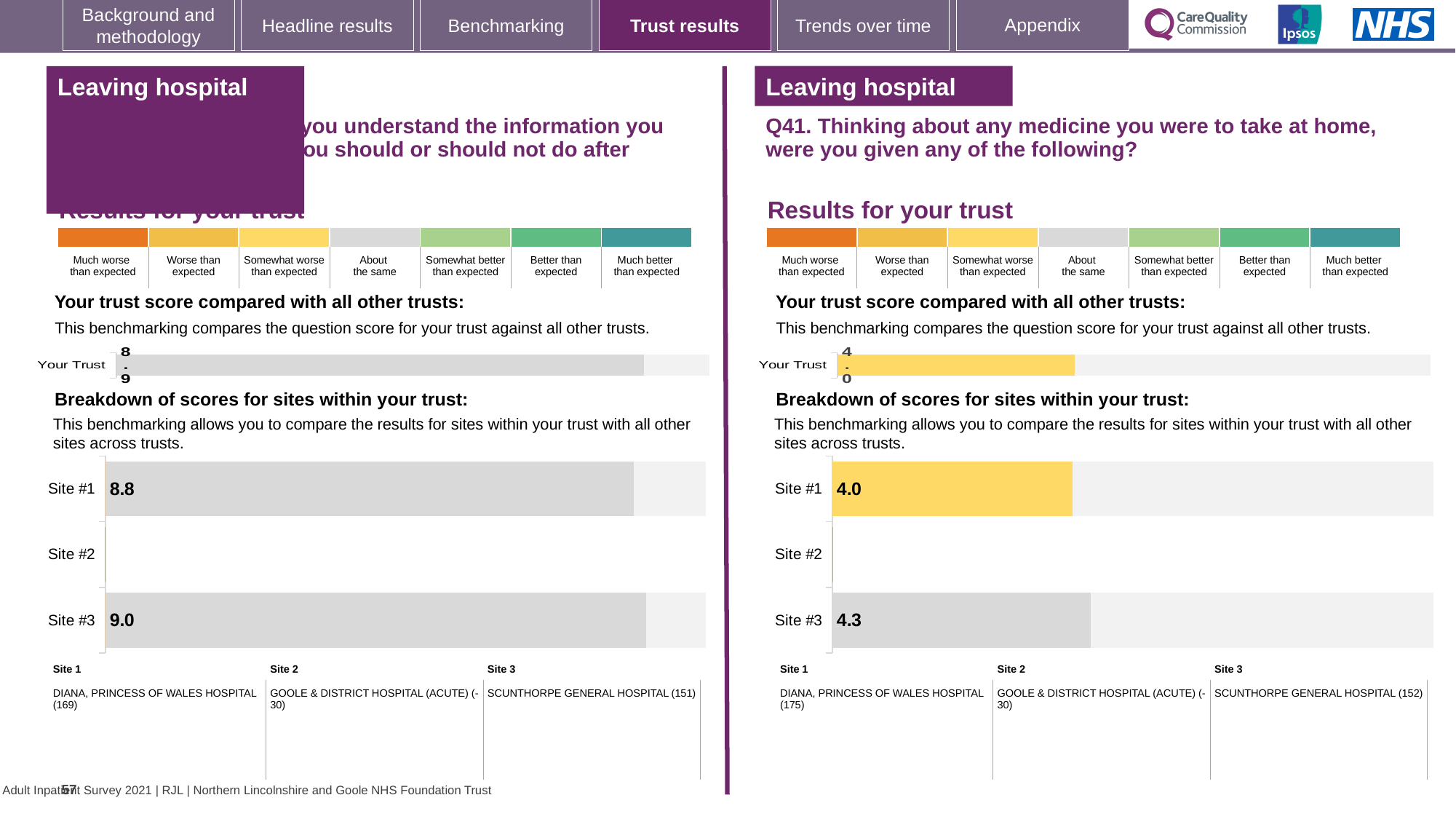
On the left-hand site breakdown chart, what is the difference between the scores for Site #3 and Site #1? 0.2 On the left-hand site breakdown chart, what is the score for Site #3? 9.0 On the right-hand (Q41) site breakdown chart, which site has the highest score? Site #3 On the right-hand (Q41) site breakdown chart, what is the score for Site #1? 4.0 On the left-hand site breakdown chart, which site has the higher score, Site #1 or Site #3? Site #3 On the left-hand site breakdown chart, what is the score for Site #1? 8.8 On the right-hand (Q41) site breakdown chart, what is the difference between the scores for Site #3 and Site #1? 0.3 What type of chart is used for the site breakdown on the left-hand side of the slide? Bar chart On the right-hand (Q41) site breakdown chart, what is the score for Site #3? 4.3 On the right-hand (Q41) 'Your trust score compared with all other trusts' chart, what is the score for Your Trust? 4.0 On the left-hand 'Your trust score compared with all other trusts' chart, what is the score for Your Trust? 8.9 How many sites are listed on the right-hand (Q41) site breakdown chart? 3